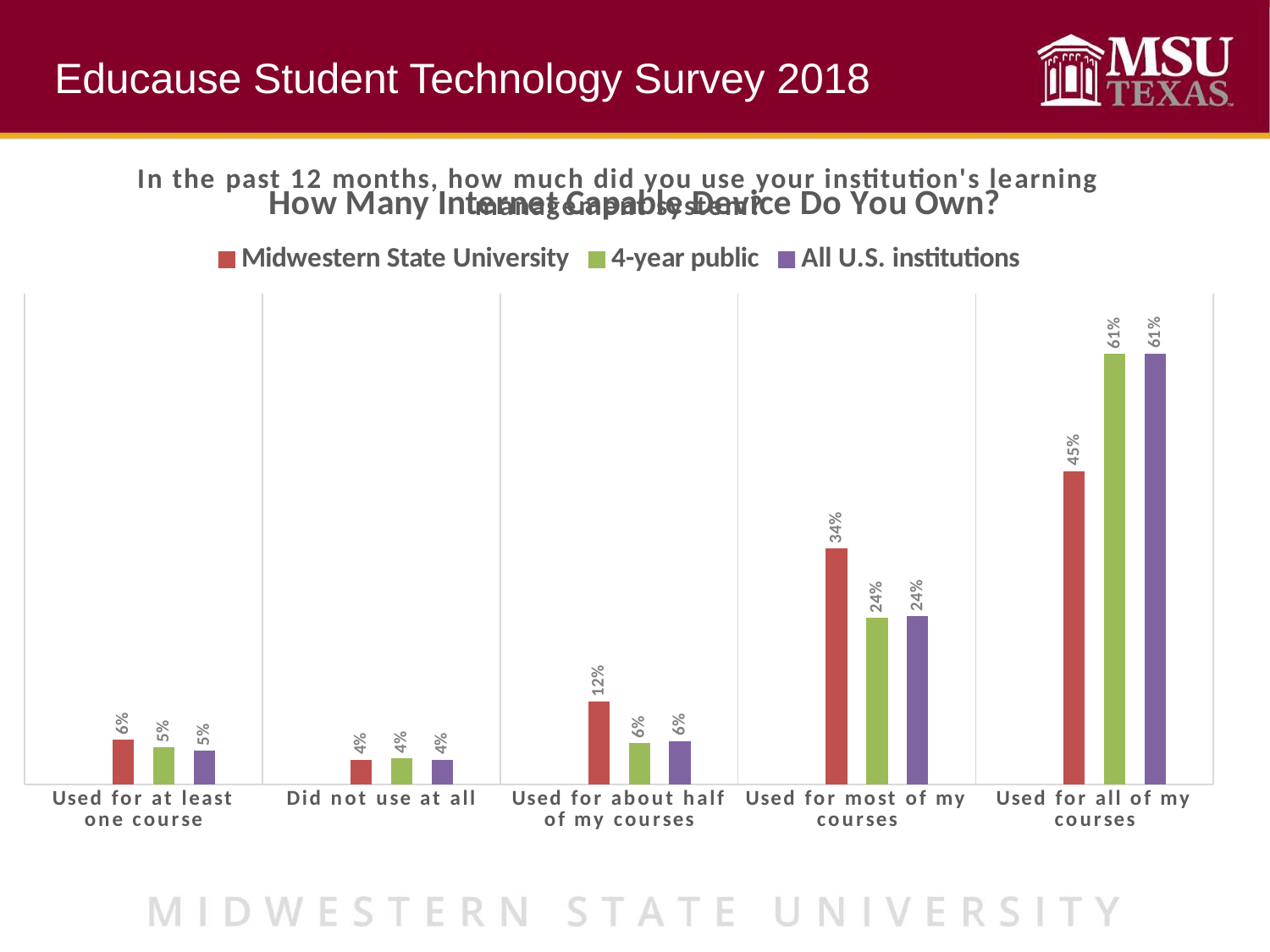
What is the difference between the 4-year public value and the Midwestern State University value in the "Used for all of my courses" category? 16% In the "Used for about half of my courses" category, which is larger: Midwestern State University or 4-year public? Midwestern State University What is the difference between the Midwestern State University value and the All U.S. institutions value in the "Used for most of my courses" category? 10% How many categories are shown on the x axis? 5 What is the value for All U.S. institutions in the "Used for about half of my courses" category? 6% What is the value for Midwestern State University in the "Did not use at all" category? 4% Which category has the lowest value for 4-year public? Did not use at all Which category has the highest value for Midwestern State University? Used for all of my courses How many series does the legend list? 3 What is the value for 4-year public in the "Used for most of my courses" category? 24% What is the value for Midwestern State University in the "Used for all of my courses" category? 45% What kind of chart is shown on the slide? Bar chart